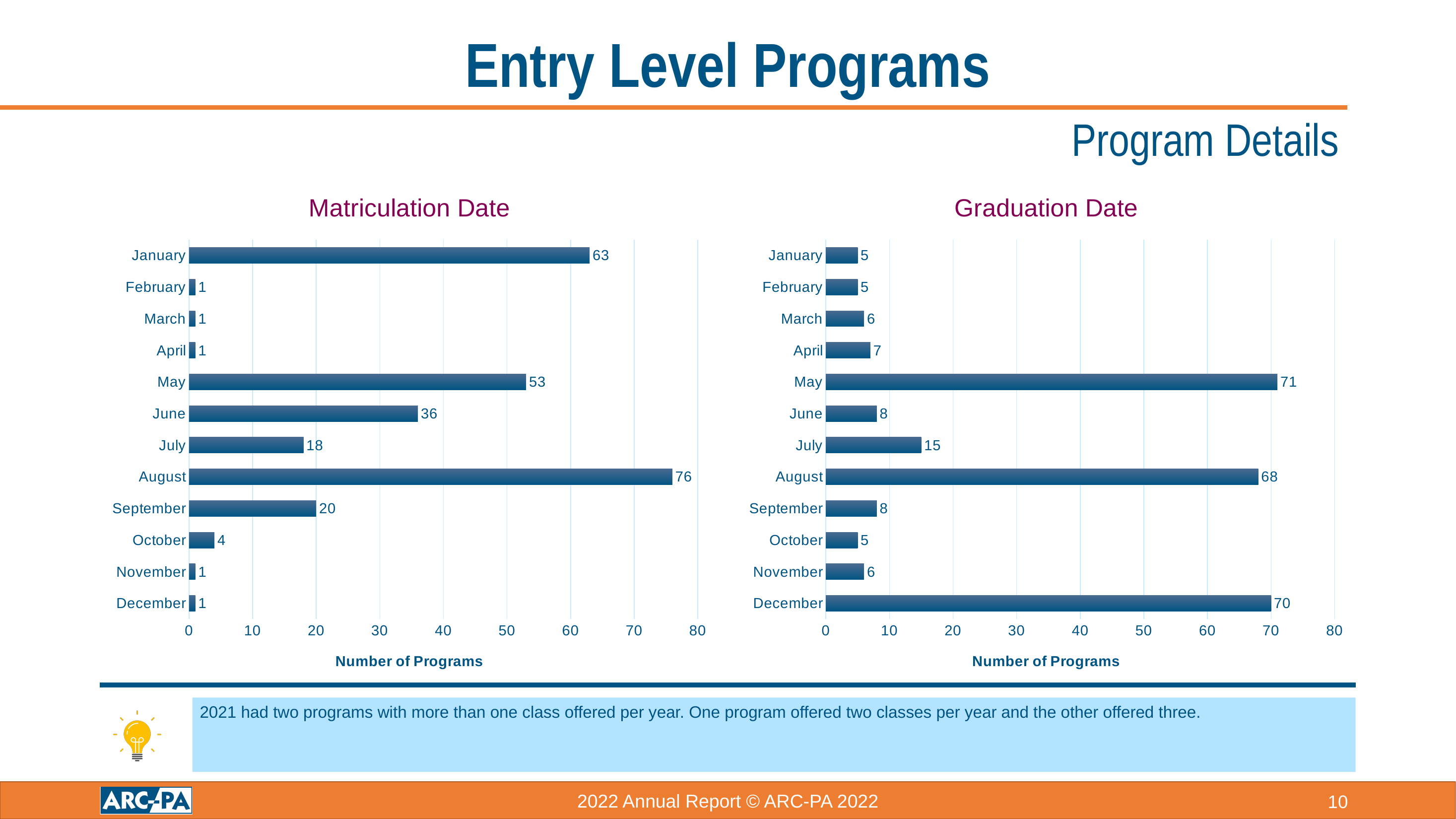
In the Graduation Date chart, is the value for July greater or less than 10? greater In the Matriculation Date chart, which is larger, the value for June or the value for July? June In the Matriculation Date chart, which month has the highest number of programs? August In the Graduation Date chart, what is the difference between the values for December and August? 2 In the Graduation Date chart, what is the value for September? 8 What kind of chart is the Graduation Date chart? bar chart In the Matriculation Date chart, what is the difference between the values for January and May? 10 How many months are shown in the Matriculation Date chart? 12 In the Graduation Date chart, which month has the highest number of programs? May In the Graduation Date chart, what is the value for May? 71 In the Matriculation Date chart, what is the value for August? 76 What is the x-axis label of the Matriculation Date chart? Number of Programs